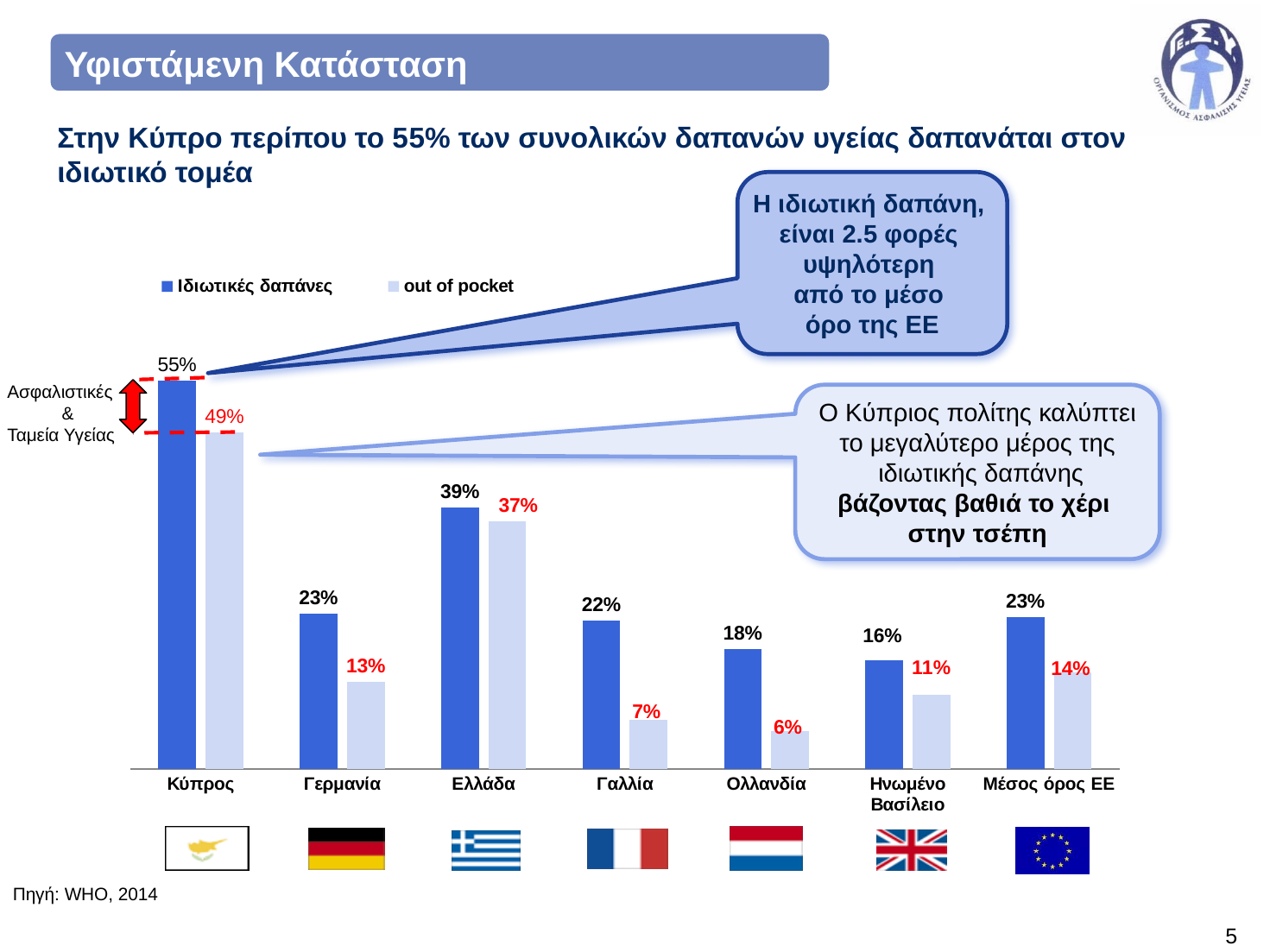
What is the difference between the Ιδιωτικές δαπάνες and out of pocket values for Γαλλία? 15% What is the value of Ιδιωτικές δαπάνες for Κύπρος? 55% What is the difference between the Ιδιωτικές δαπάνες value for Κύπρος and for Μέσος όρος ΕΕ? 32% What kind of chart is shown on the slide? Bar chart Which category has the highest out of pocket value? Κύπρος Which category has the lowest value for Ιδιωτικές δαπάνες? Ηνωμένο Βασίλειο What is the out of pocket value for Ελλάδα? 37% What is the out of pocket value for Ολλανδία? 6% Which is larger: the out of pocket value for Γερμανία or for Ηνωμένο Βασίλειο? Γερμανία How many categories are shown on the x axis of the chart? 7 What is the value of Ιδιωτικές δαπάνες for Μέσος όρος ΕΕ? 23% How many series does the chart legend list? 2